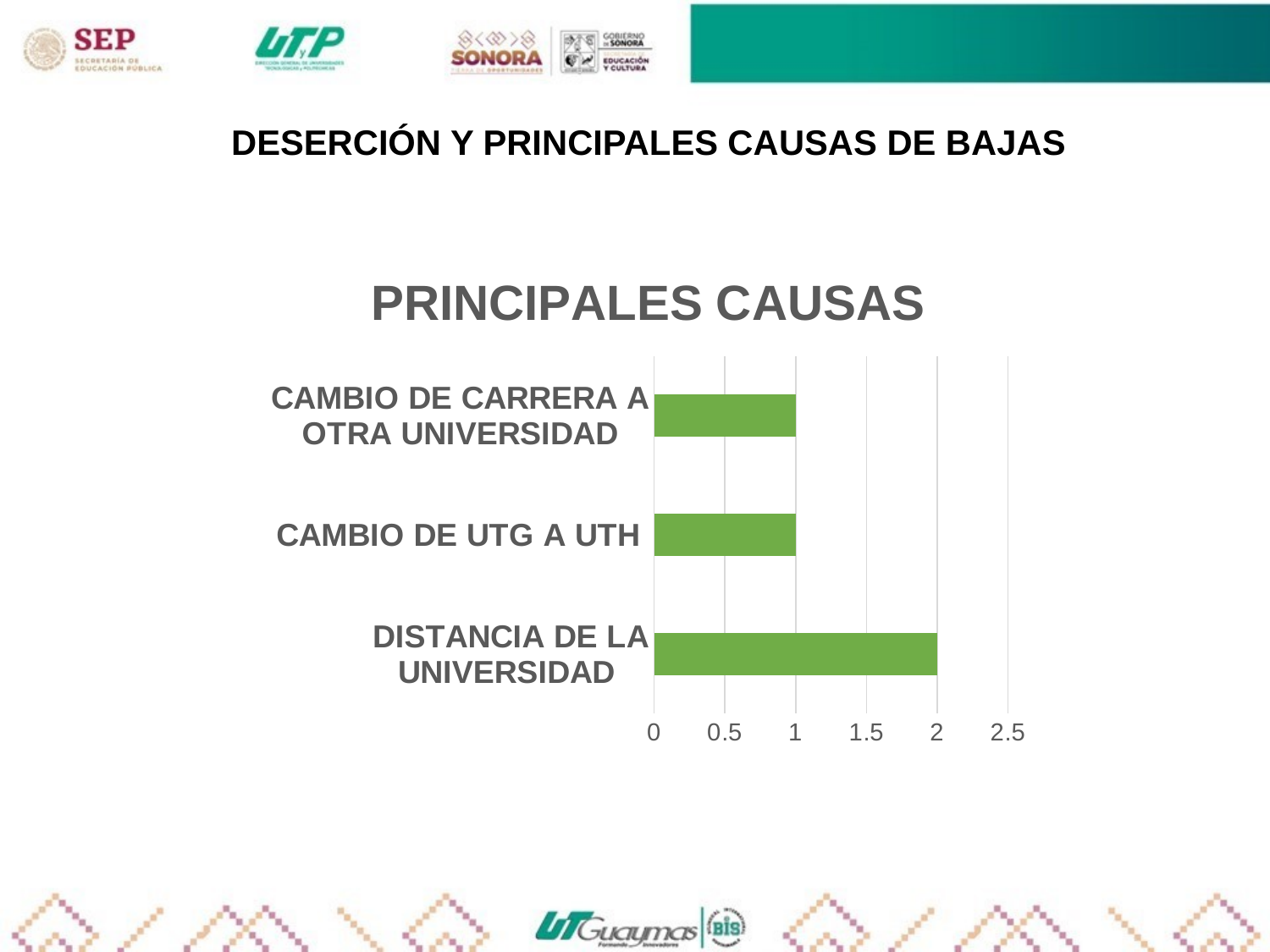
What kind of chart is the PRINCIPALES CAUSAS chart? bar chart What colour are the bars in the PRINCIPALES CAUSAS chart? green What is the title of the chart on the slide? PRINCIPALES CAUSAS What is the value for CAMBIO DE UTG A UTH in the PRINCIPALES CAUSAS chart? 1 Which category has the highest value in the PRINCIPALES CAUSAS chart? DISTANCIA DE LA UNIVERSIDAD Is the value for DISTANCIA DE LA UNIVERSIDAD greater or less than 1.5? greater Is the value for CAMBIO DE UTG A UTH greater or less than 1.5? less How many categories are shown in the PRINCIPALES CAUSAS chart? 3 What is the value for DISTANCIA DE LA UNIVERSIDAD in the PRINCIPALES CAUSAS chart? 2 What is the difference between the values for DISTANCIA DE LA UNIVERSIDAD and CAMBIO DE UTG A UTH? 1 What is the value for CAMBIO DE CARRERA A OTRA UNIVERSIDAD in the PRINCIPALES CAUSAS chart? 1 Which is larger: the value for DISTANCIA DE LA UNIVERSIDAD or the value for CAMBIO DE CARRERA A OTRA UNIVERSIDAD? DISTANCIA DE LA UNIVERSIDAD